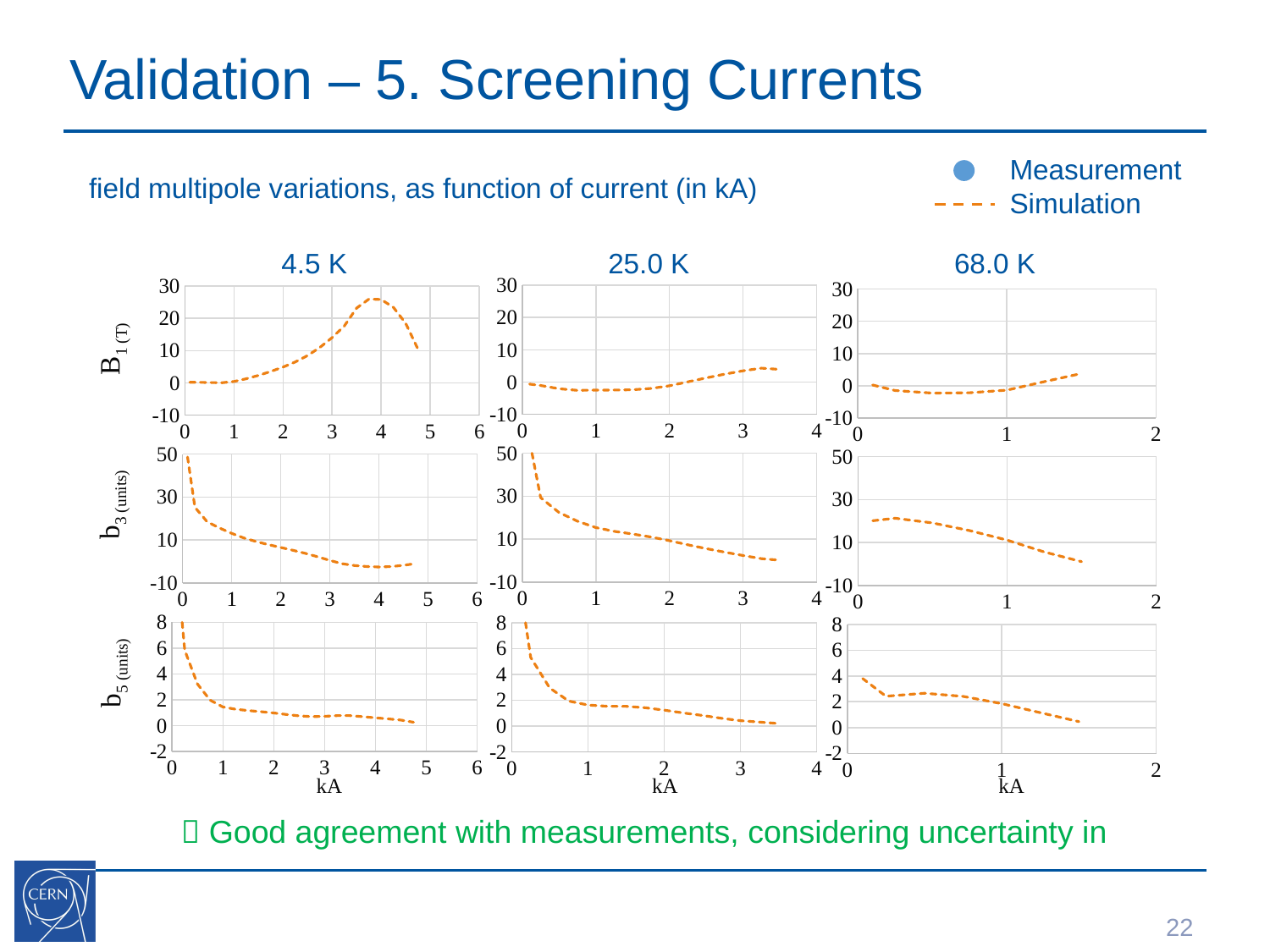
In the b5 chart for 4.5 K, do the simulation values rise or fall as current increases from 0 to 1 kA? fall In the b5 chart for 25.0 K, is the simulation value at 3 kA greater or less than 2? less How many series does the legend at the top right list? 2 What kind of chart is used in the B1 panel for 4.5 K? line chart In the B1 chart for 25.0 K, is the simulation value at 3 kA greater or less than 10? less In the b3 chart for 4.5 K, do the simulation values rise or fall as current increases from 1 kA to 4 kA? fall In the b3 chart for 4.5 K, is the simulation value at 4 kA greater or less than 10? less Which has the larger peak B1 simulation value: the 4.5 K chart or the 25.0 K chart? 4.5 K According to the legend, what line style represents the Simulation series? orange dashed line How many chart panels are shown on the slide? 9